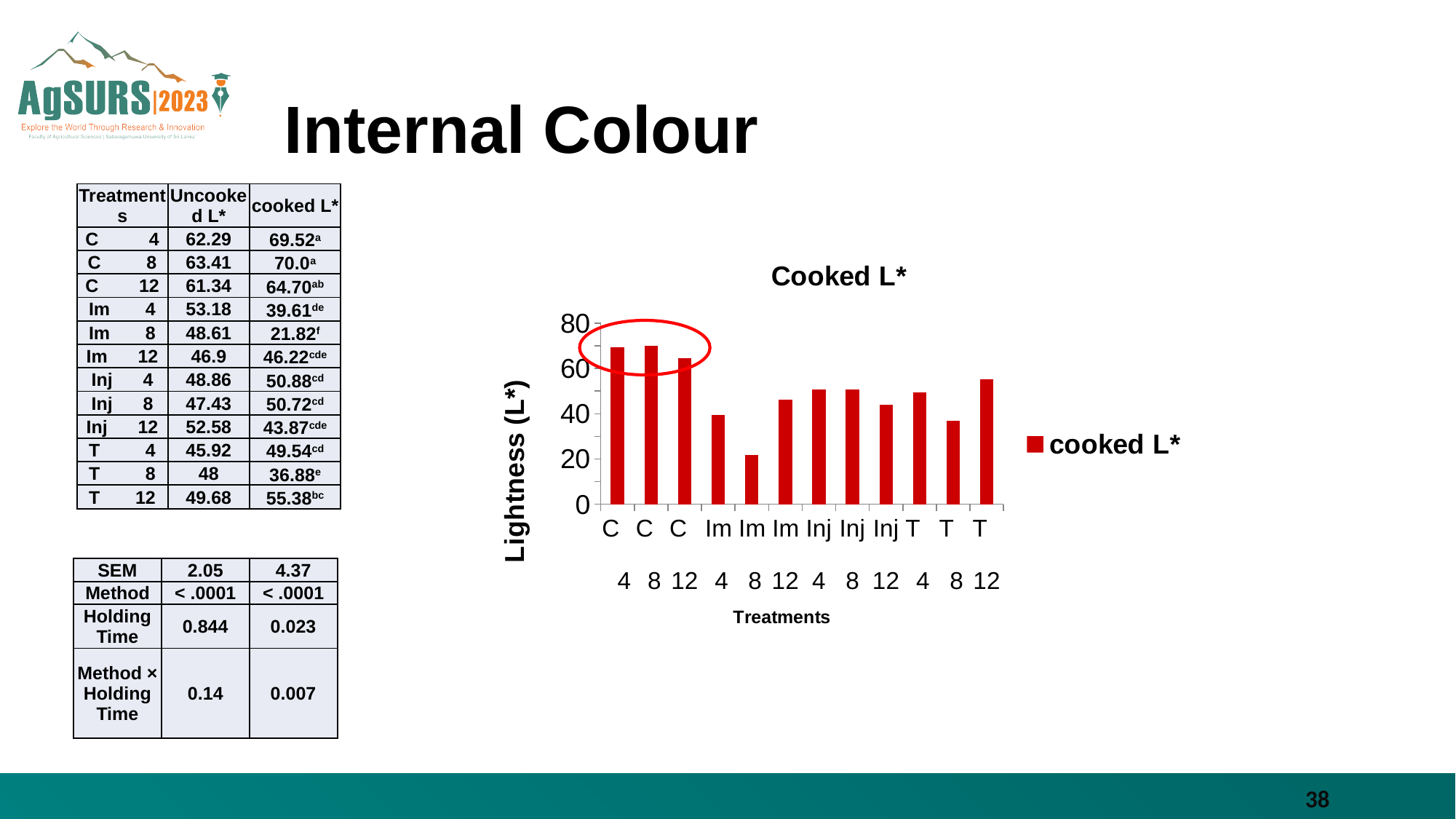
Which treatment has the lowest cooked L* bar in the chart? Im 8 Is the cooked L* value for T 12 greater or less than 40? greater Is the cooked L* value for Inj 4 greater or less than 40? greater What kind of chart is shown on the slide? bar chart Which has the larger cooked L* bar, T 12 or T 8? T 12 Is the cooked L* value for C 4 greater or less than 60? greater What is the title of the chart? Cooked L* How many bars are plotted in the chart? 12 How many series does the chart legend list? 1 What is the label on the vertical axis of the chart? Lightness (L*) Which has the larger cooked L* bar, Im 4 or Inj 4? Inj 4